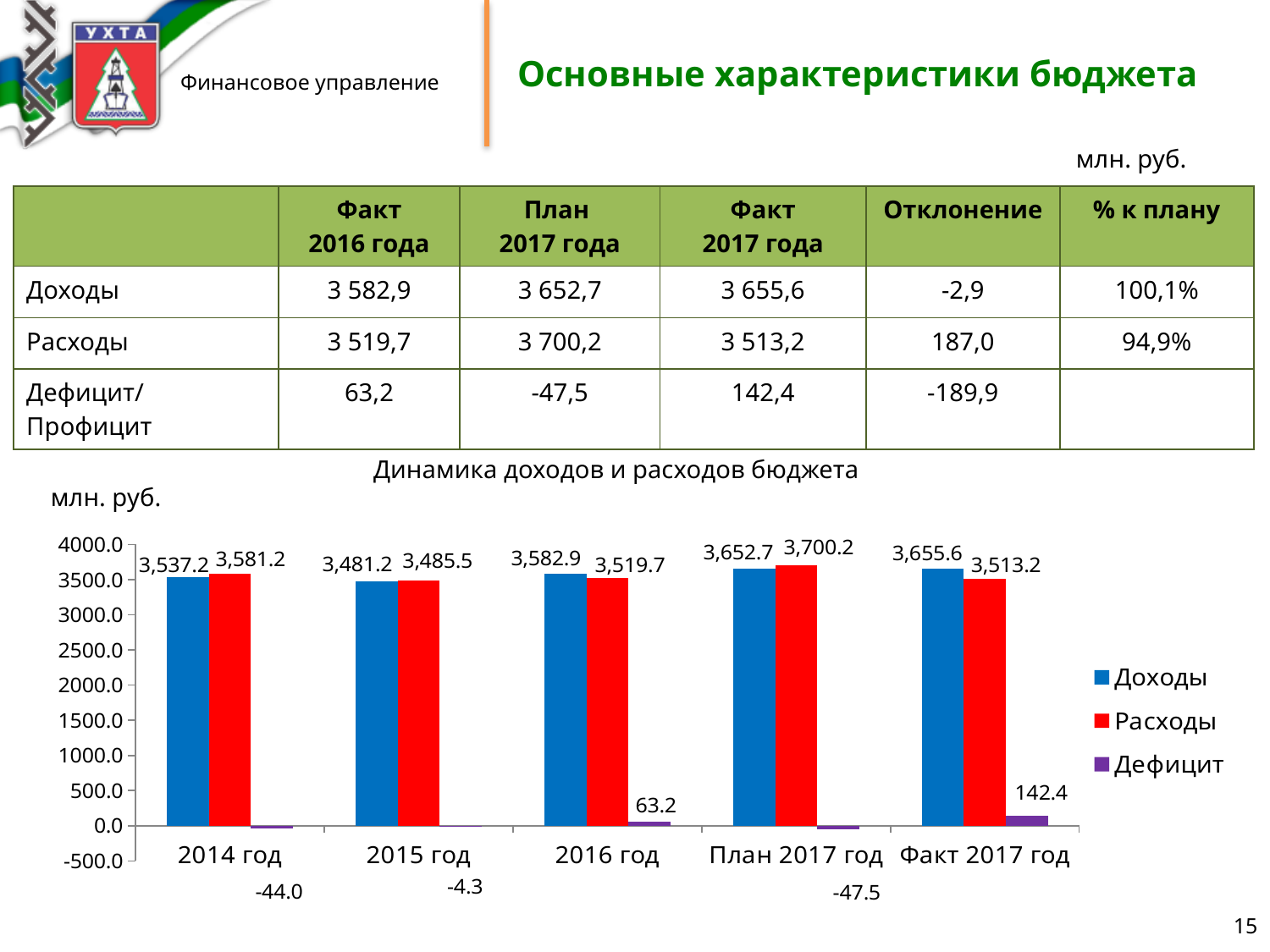
What is the title of the chart on the slide? Динамика доходов и расходов бюджета What type of chart is shown on the slide? Bar chart What is the value of Доходы for 2014 год in the chart? 3,537.2 Which category has the highest Расходы value in the chart? План 2017 год What is the value of Расходы for План 2017 год in the chart? 3,700.2 How many categories are shown on the x axis of the chart? 5 What is the difference between Расходы and Доходы for 2014 год in the chart? 44.0 How many series does the chart legend list? 3 What is the value of Дефицит for 2015 год in the chart? -4.3 Which category has the lowest Доходы value in the chart? 2015 год What is the value of Дефицит for Факт 2017 год in the chart? 142.4 For 2016 год, which is larger in the chart: Доходы or Расходы? Доходы